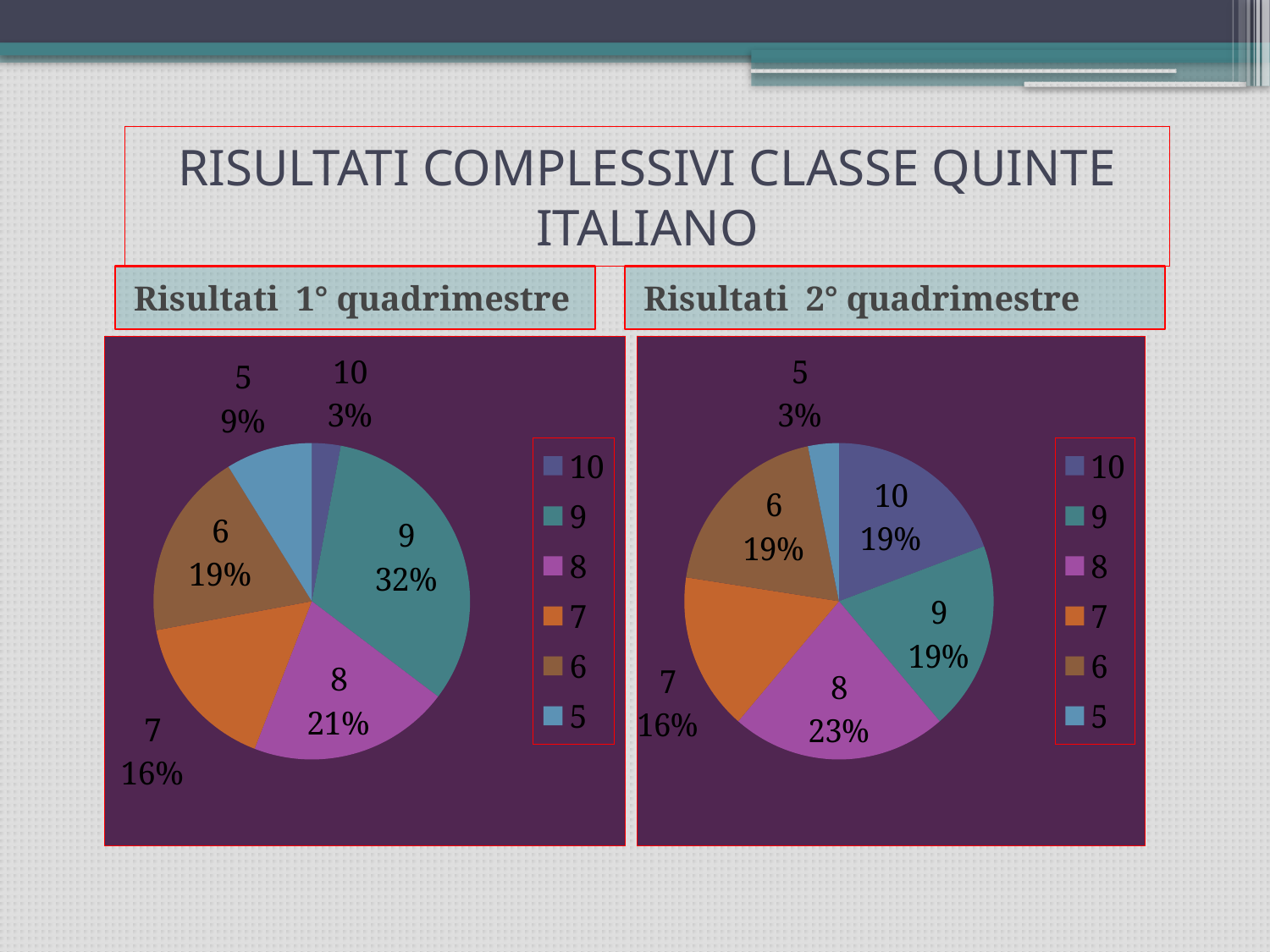
In the 'Risultati 1° quadrimestre' chart, which grade has the largest slice? 9 What type of chart is the 'Risultati 1° quadrimestre' chart? Pie chart In the 'Risultati 2° quadrimestre' chart, which grade has the largest slice? 8 How many slices does the 'Risultati 2° quadrimestre' pie chart have? 6 In the 'Risultati 1° quadrimestre' chart, what share of the pie does grade 9 have? 32% In the 'Risultati 2° quadrimestre' chart, which grade has the smallest slice? 5 In the 'Risultati 1° quadrimestre' chart, what is the difference in percentage points between the shares for grade 9 and grade 8? 11 In the 'Risultati 1° quadrimestre' chart, what share of the pie does grade 5 have? 9% In the 'Risultati 2° quadrimestre' chart, what share of the pie does grade 5 have? 3% In the 'Risultati 2° quadrimestre' chart, what share of the pie does grade 8 have? 23% In the 'Risultati 1° quadrimestre' chart, which grade has the smallest slice? 10 In the 'Risultati 2° quadrimestre' chart, which is larger, the share for grade 8 or the share for grade 7? 8